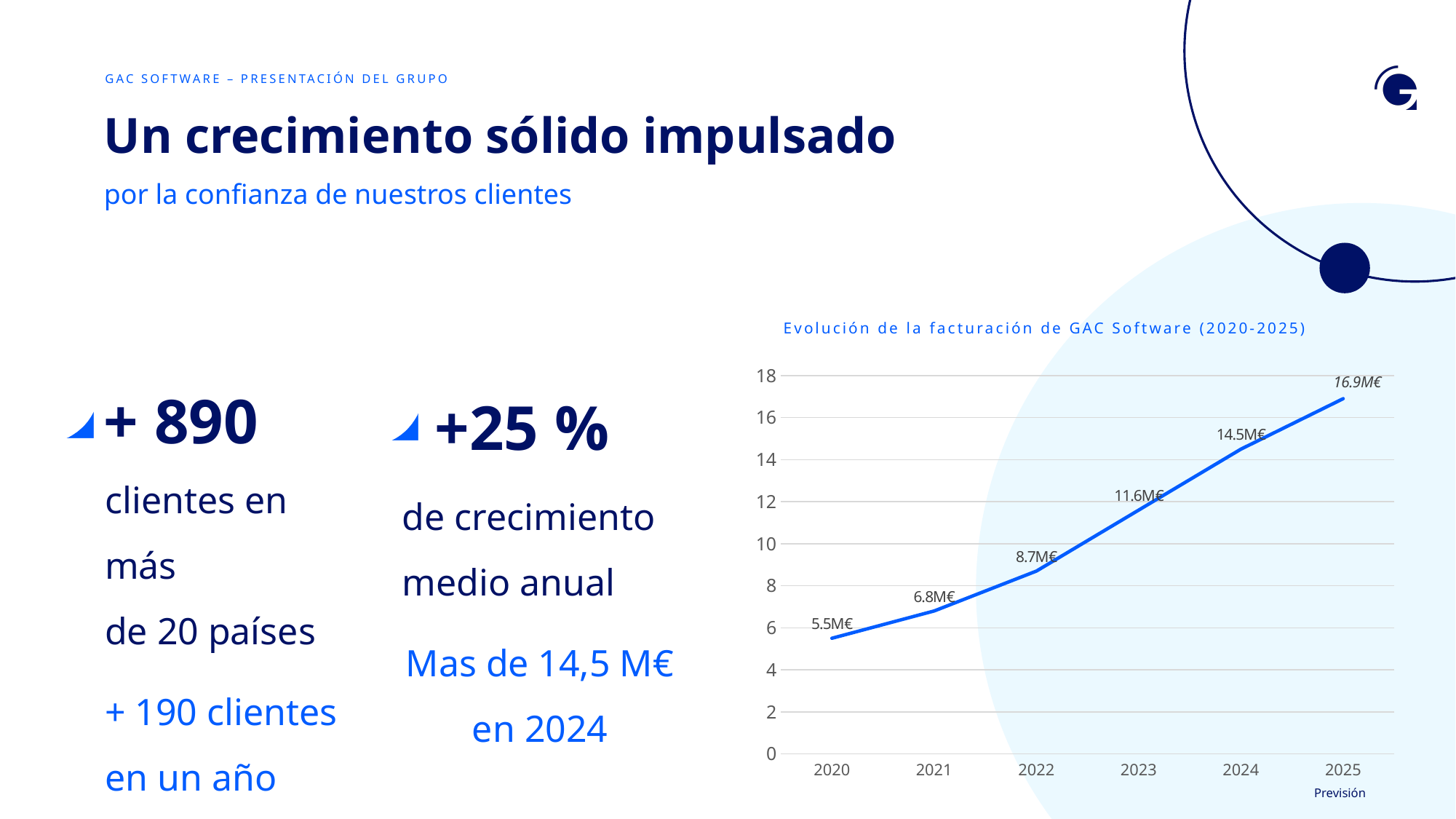
Which is larger in the chart, the value for 2021 or the value for 2023? 2023 How many years are plotted in the chart? 6 What is the value for 2024 in the chart? 14.5M€ What is the forecast value for 2025 in the chart? 16.9M€ Which year has the lowest value in the chart? 2020 Which year has the highest value in the chart? 2025 What kind of chart is shown on the slide? line chart What is the value for 2022 in the chart? 8.7M€ What is the difference between the 2024 and 2023 values in the chart? 2.9M€ Do the values rise or fall from 2020 to 2025 in the chart? rise Is the value for 2022 greater or less than 10? less What is the value for 2020 in the chart? 5.5M€